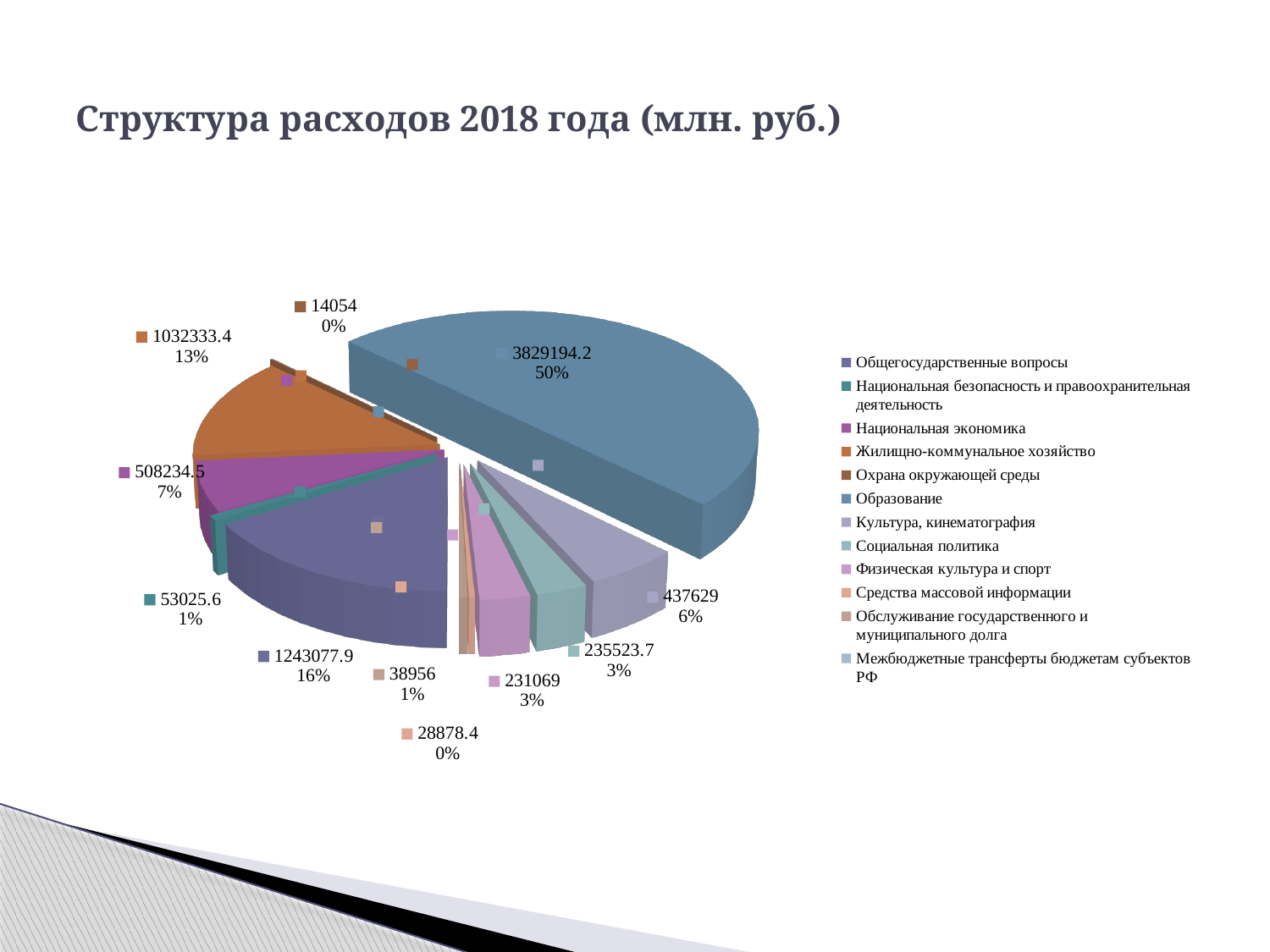
What share of the pie does the largest slice (3829194.2) represent? 50% Which is larger, Общегосударственные вопросы or Жилищно-коммунальное хозяйство? Общегосударственные вопросы What is the value for Общегосударственные вопросы? 1243077.9 What kind of chart is shown on the slide? pie chart How many entries does the chart legend list? 12 What share of the pie does Жилищно-коммунальное хозяйство represent? 13% What is the difference between the values for Общегосударственные вопросы (1243077.9) and Жилищно-коммунальное хозяйство (1032333.4)? 210744.5 What is the value for Национальная экономика? 508234.5 What is the value for Охрана окружающей среды? 14054 What is the value for Жилищно-коммунальное хозяйство? 1032333.4 What is the title of the chart? Структура расходов 2018 года (млн. руб.) What is the largest value labelled on the pie chart? 3829194.2